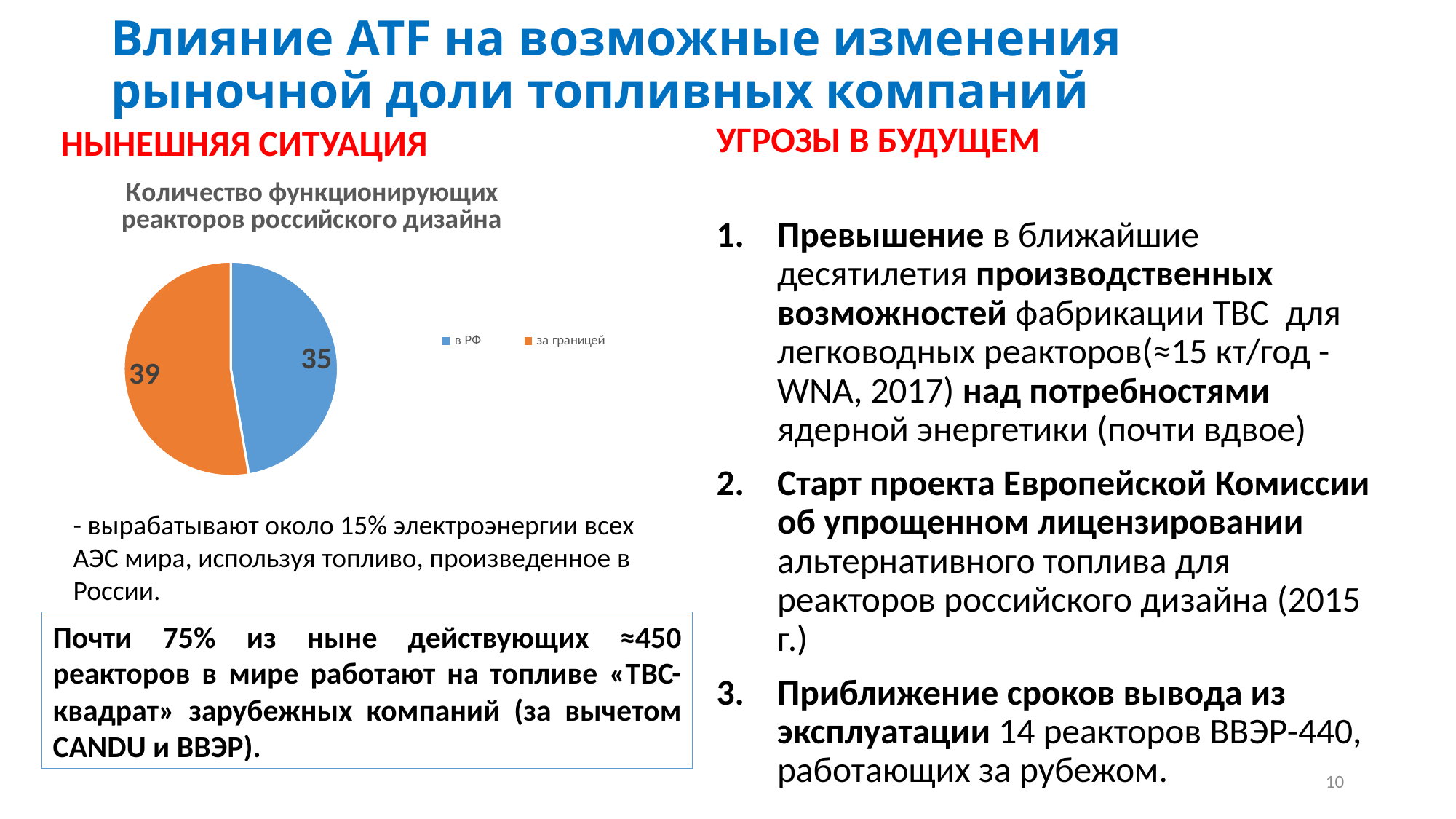
What type of chart is shown on the slide? pie chart Which slice of the pie chart is the smallest? в РФ What is the title of the pie chart? Количество функционирующих реакторов российского дизайна What is the value for the slice "в РФ"? 35 Which is larger: the value for "в РФ" or the value for "за границей"? за границей What is the value for the slice "за границей"? 39 What is the difference between the values for "за границей" and "в РФ"? 4 How many slices does the pie chart have? 2 What colour is the slice for "за границей"? orange What is the total of the two values shown in the pie chart? 74 How many entries does the legend of the pie chart list? 2 Which slice of the pie chart is the largest? за границей